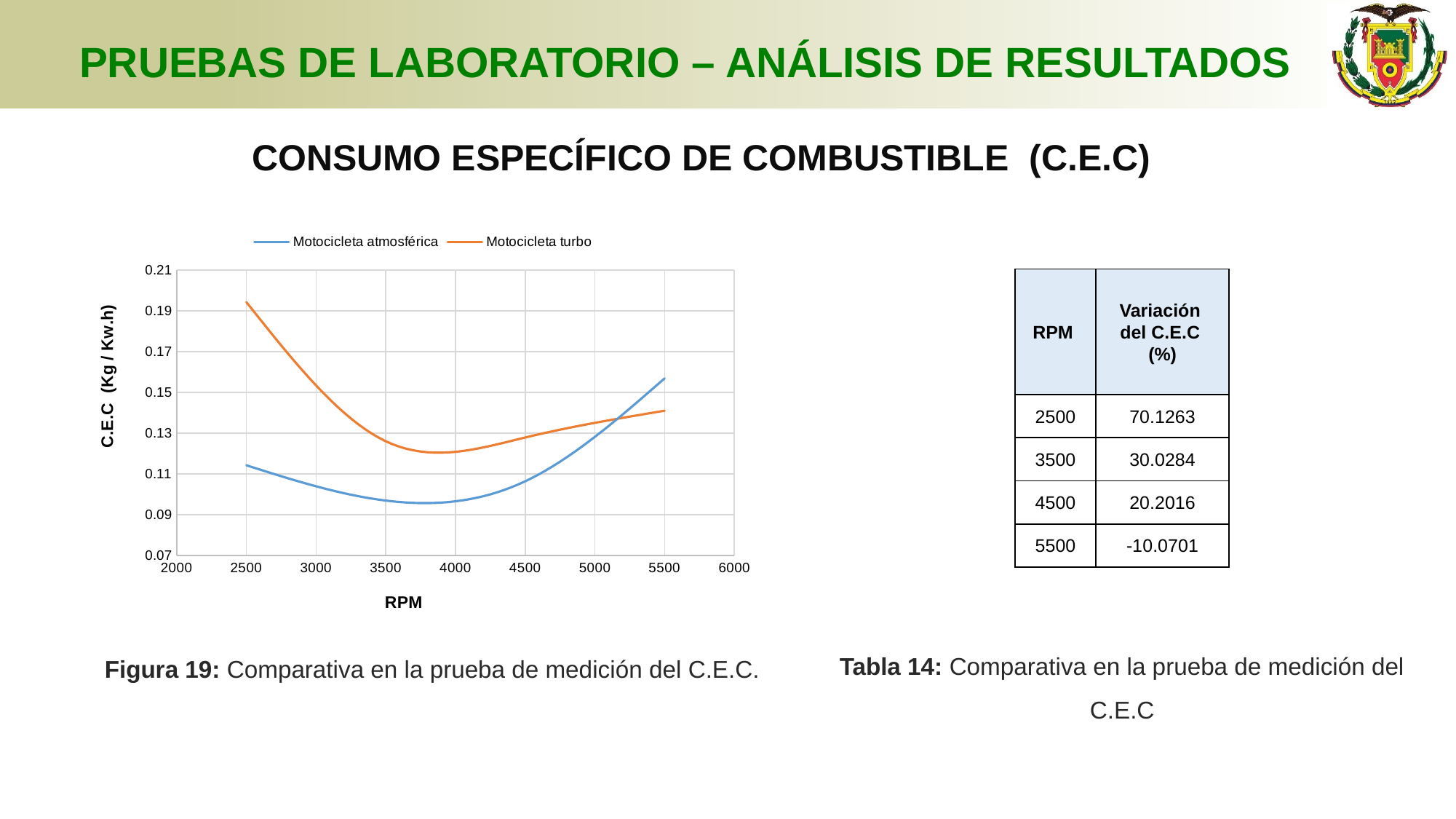
What are the two series named in the chart legend? Motocicleta atmosférica and Motocicleta turbo At 5500 RPM, which series has the higher C.E.C value? Motocicleta atmosférica How many series does the legend of the chart list? 2 What kind of chart is shown in Figura 19? line chart At 2500 RPM, which series has the higher C.E.C value? Motocicleta turbo What is the label of the vertical axis of the chart? C.E.C (Kg / Kw.h) Is the lowest value of the Motocicleta atmosférica line greater or less than 0.11? less Does the Motocicleta turbo line rise or fall between 2500 and 3500 RPM? fall Is the value for Motocicleta turbo at 5500 RPM greater or less than 0.15? less Is the value for Motocicleta turbo at 2500 RPM greater or less than 0.17? greater